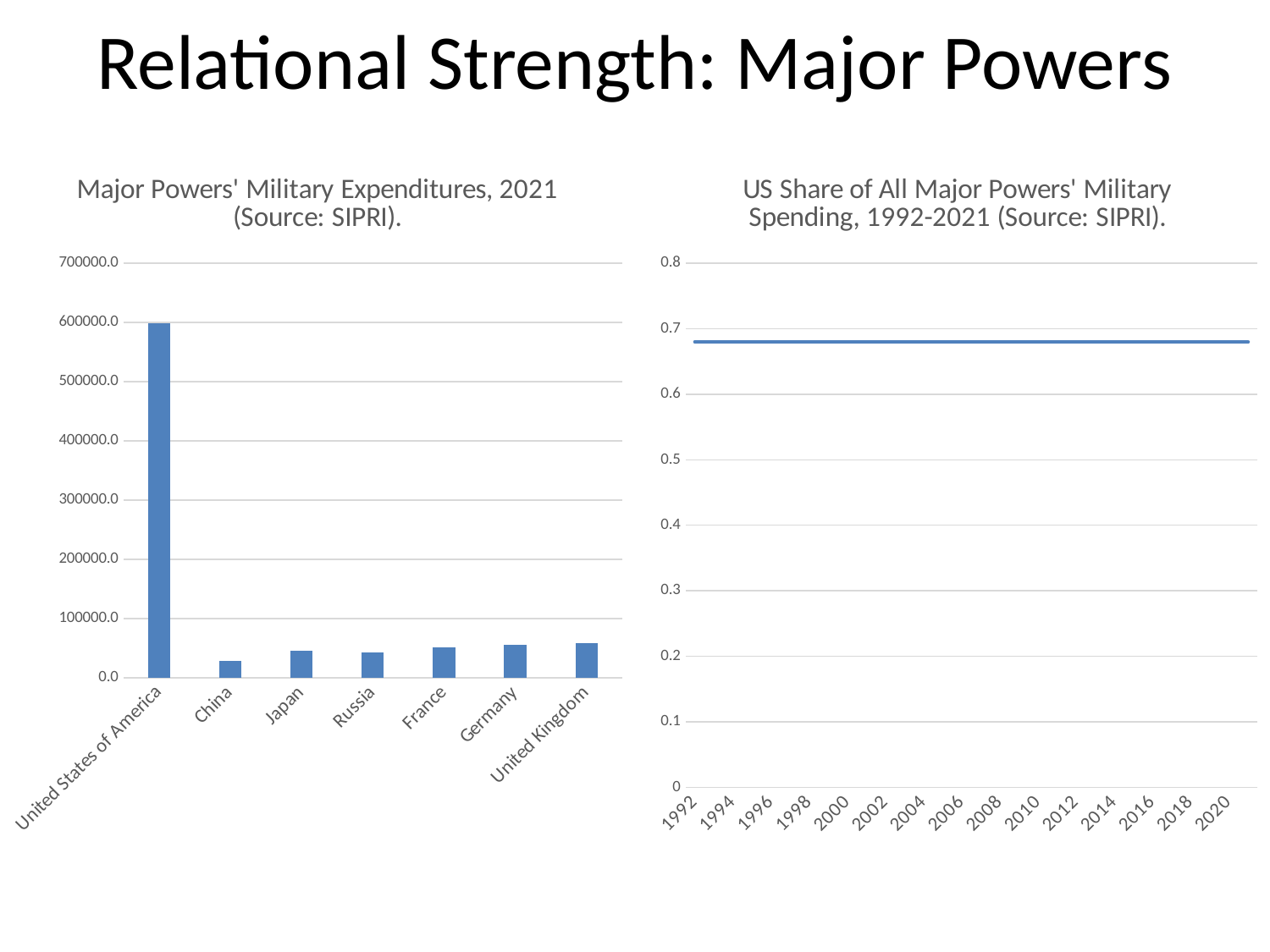
In the left chart, which has the larger military expenditure, United Kingdom or Japan? United Kingdom In the left chart, which country has the highest military expenditure? United States of America In the left chart, is the value for the United States of America greater or less than 500000.0? greater In the left chart, which country has the lowest military expenditure? China In the right chart, does the US share rise, fall, or stay roughly flat from 1992 to 2020? stays roughly flat What type of chart is the right chart, 'US Share of All Major Powers' Military Spending, 1992-2021'? line chart In the left chart, which has the larger military expenditure, Germany or China? Germany What type of chart is the left chart, 'Major Powers' Military Expenditures, 2021'? bar chart In the right chart, is the US share in 2010 greater or less than 0.6? greater What source is cited in the titles of both charts? SIPRI In the left chart, is the value for China greater or less than 100000.0? less In the left chart, how many countries are shown on the x axis? 7